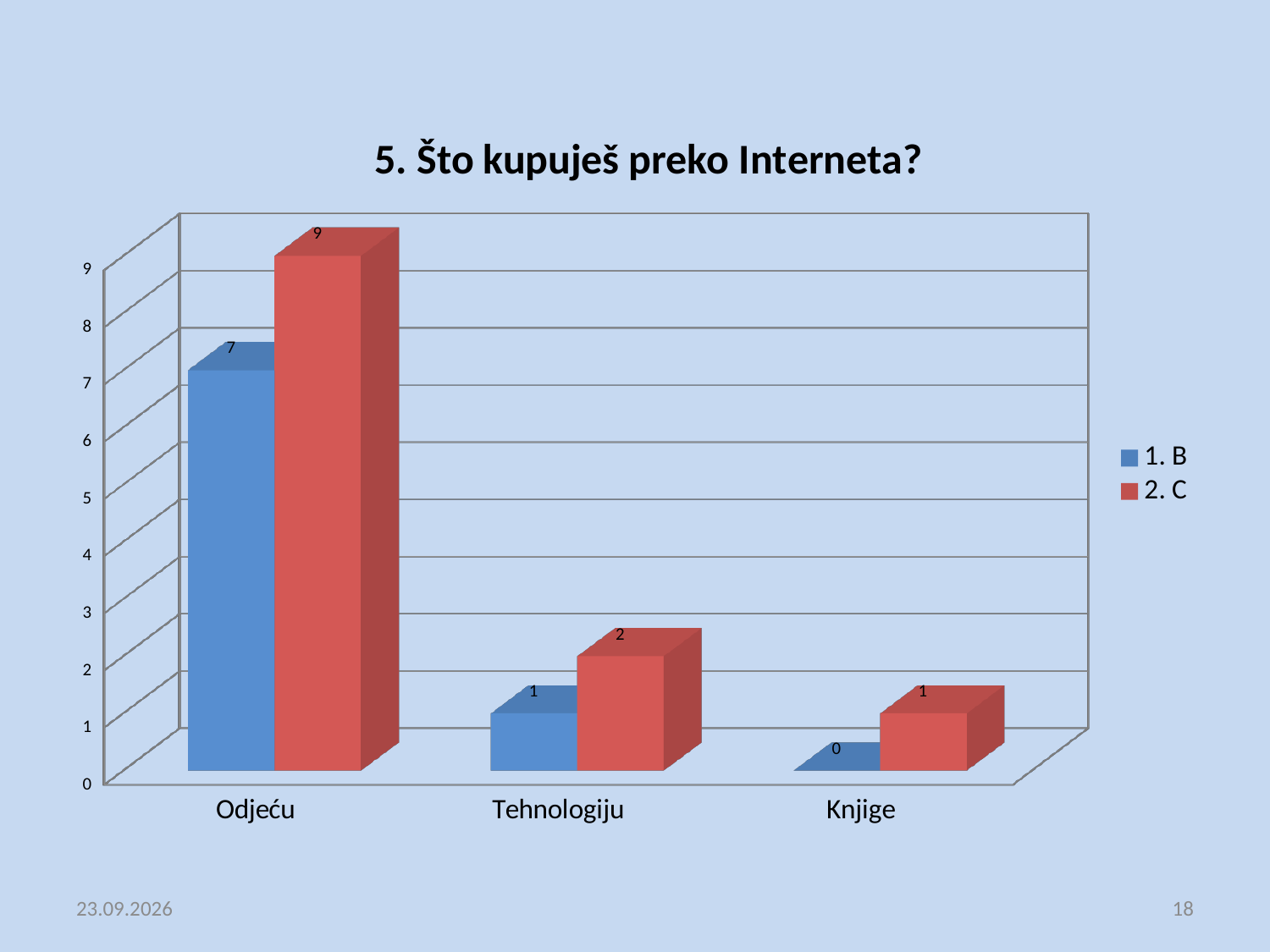
Which category has the lowest value in series 1. B? Knjige Which category has the highest value in series 2. C? Odjeću What is the value for Odjeću in series 2. C? 9 How many categories are shown on the x axis? 3 What kind of chart is shown on the slide? Bar chart What is the value for Tehnologiju in series 2. C? 2 How many series does the legend list? 2 What is the title of the chart? 5. Što kupuješ preko Interneta? What is the value for Knjige in series 1. B? 0 Which is larger for Tehnologiju: the 1. B value or the 2. C value? 2. C What is the difference between the 2. C and 1. B values for Odjeću? 2 What is the value for Odjeću in series 1. B? 7